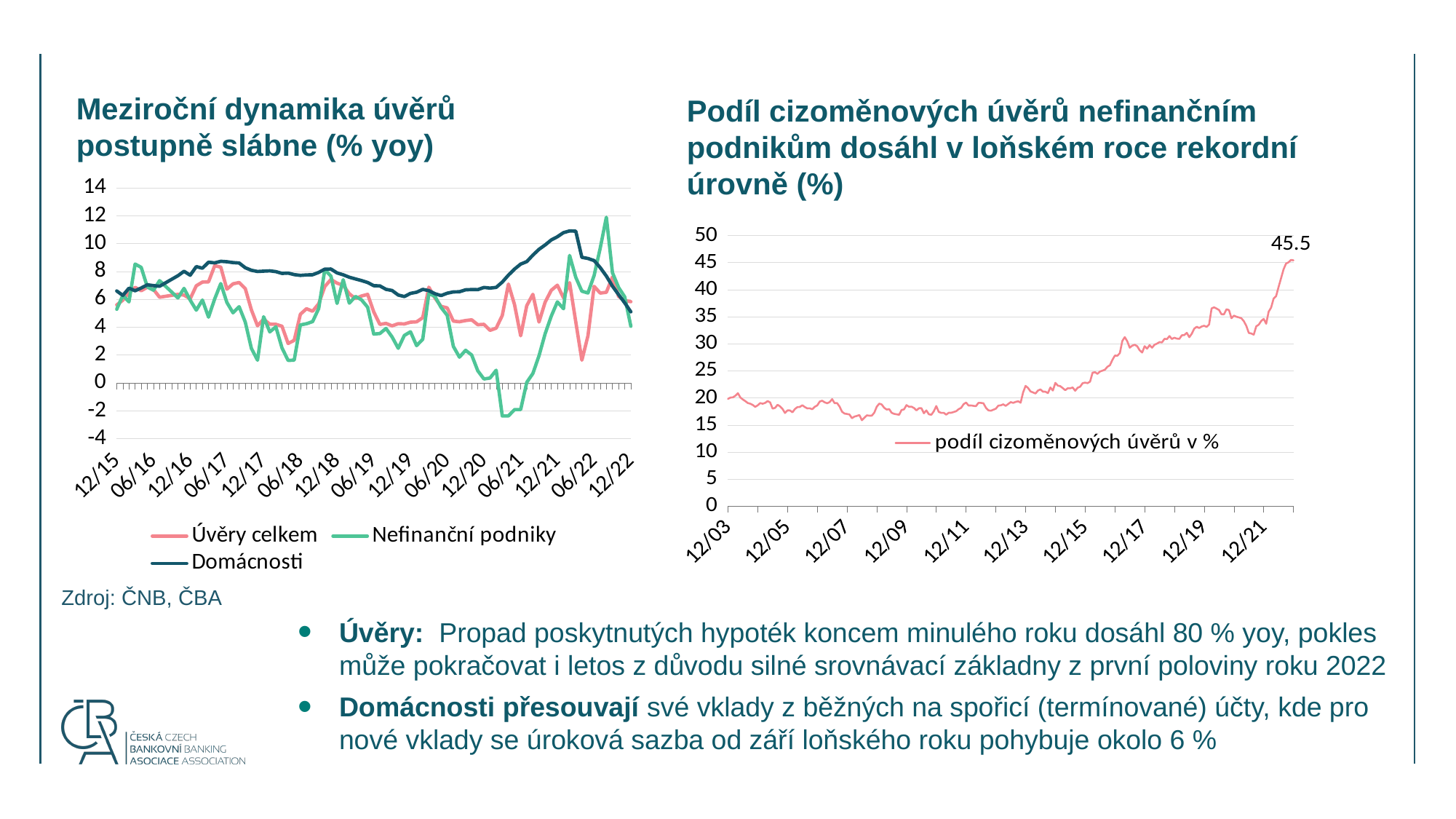
On the left chart (Meziroční dynamika úvěrů postupně slábne), which series reaches the highest value anywhere on the chart? Nefinanční podniky How many series does the legend of the right chart (Podíl cizoměnových úvěrů nefinančním podnikům) list? 1 On the left chart (Meziroční dynamika úvěrů postupně slábne), is the lowest value of Nefinanční podniky around 06/21 greater or less than 0? less What kind of chart is the left chart (Meziroční dynamika úvěrů postupně slábne)? line chart How many series does the legend of the left chart (Meziroční dynamika úvěrů postupně slábne) list? 3 On the right chart (Podíl cizoměnových úvěrů nefinančním podnikům), what is the value shown by the data label at the end of the line? 45.5 On the left chart (Meziroční dynamika úvěrů postupně slábne), which series reaches the lowest value anywhere on the chart? Nefinanční podniky On the left chart (Meziroční dynamika úvěrů postupně slábne), is the peak value of Domácnosti around 12/21 greater or less than 10? greater On the left chart (Meziroční dynamika úvěrů postupně slábne), does the Domácnosti series rise or fall between 12/21 and 12/22? fall On the right chart (Podíl cizoměnových úvěrů nefinančním podnikům), is the value at 12/03 greater or less than 25? less On the right chart (Podíl cizoměnových úvěrů nefinančním podnikům), does the line overall rise or fall from 12/03 to the end of the series? rise What is the legend entry of the right chart (Podíl cizoměnových úvěrů nefinančním podnikům)? podíl cizoměnových úvěrů v %